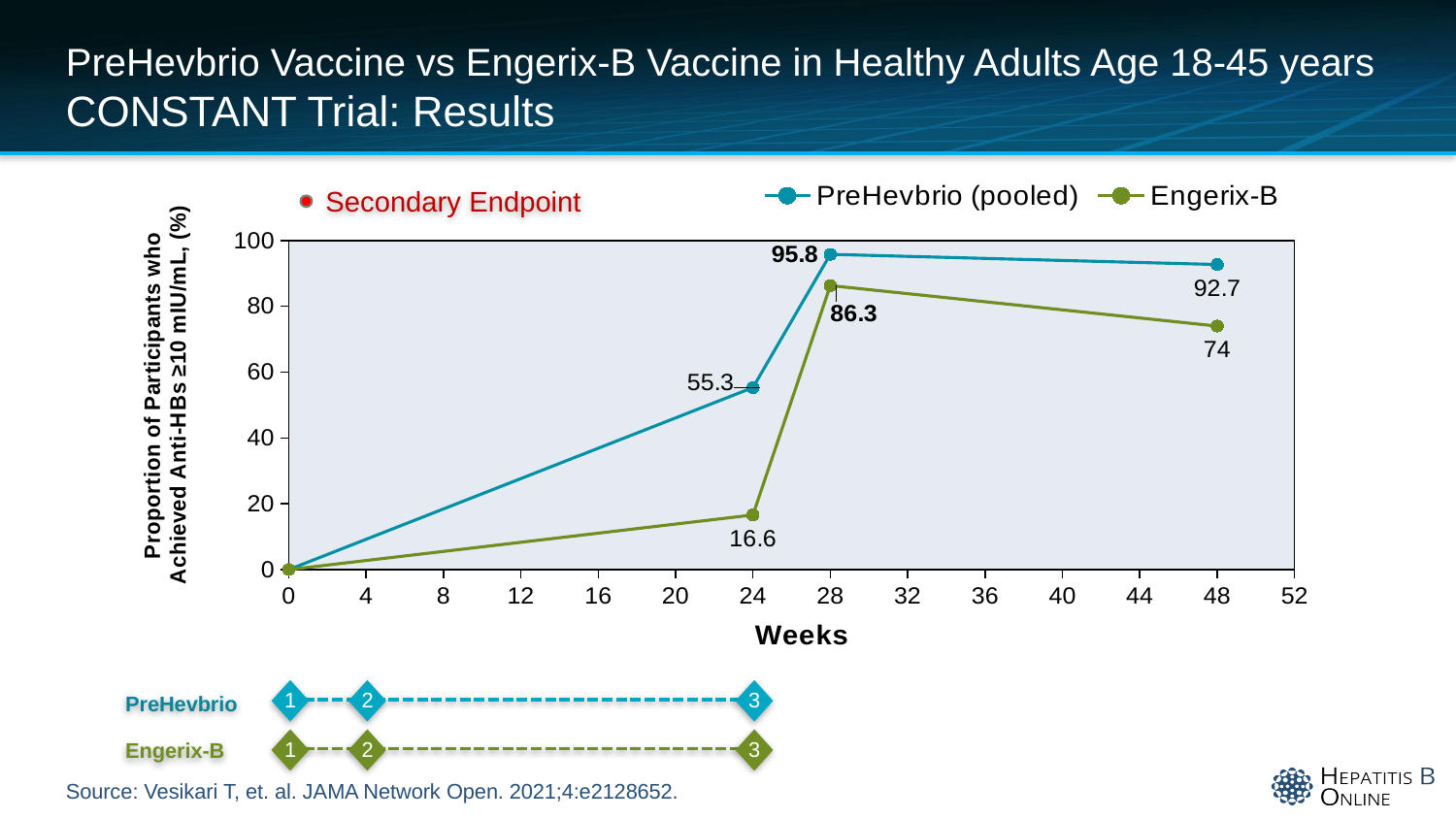
Is the value for Engerix-B at week 24 greater or less than 20? less What is the value for Engerix-B at week 24? 16.6 What is the difference between PreHevbrio (pooled) and Engerix-B at week 24? 38.7 What is the label of the x axis? Weeks How many series does the legend list? 2 What is the value for Engerix-B at week 48? 74 What kind of chart is shown on the slide? line chart Which series has the higher value at week 28, PreHevbrio (pooled) or Engerix-B? PreHevbrio (pooled) What is the difference between PreHevbrio (pooled) and Engerix-B at week 48? 18.7 What is the value for PreHevbrio (pooled) at week 48? 92.7 What is the value for PreHevbrio (pooled) at week 28? 95.8 At which week does Engerix-B reach its highest value? 28